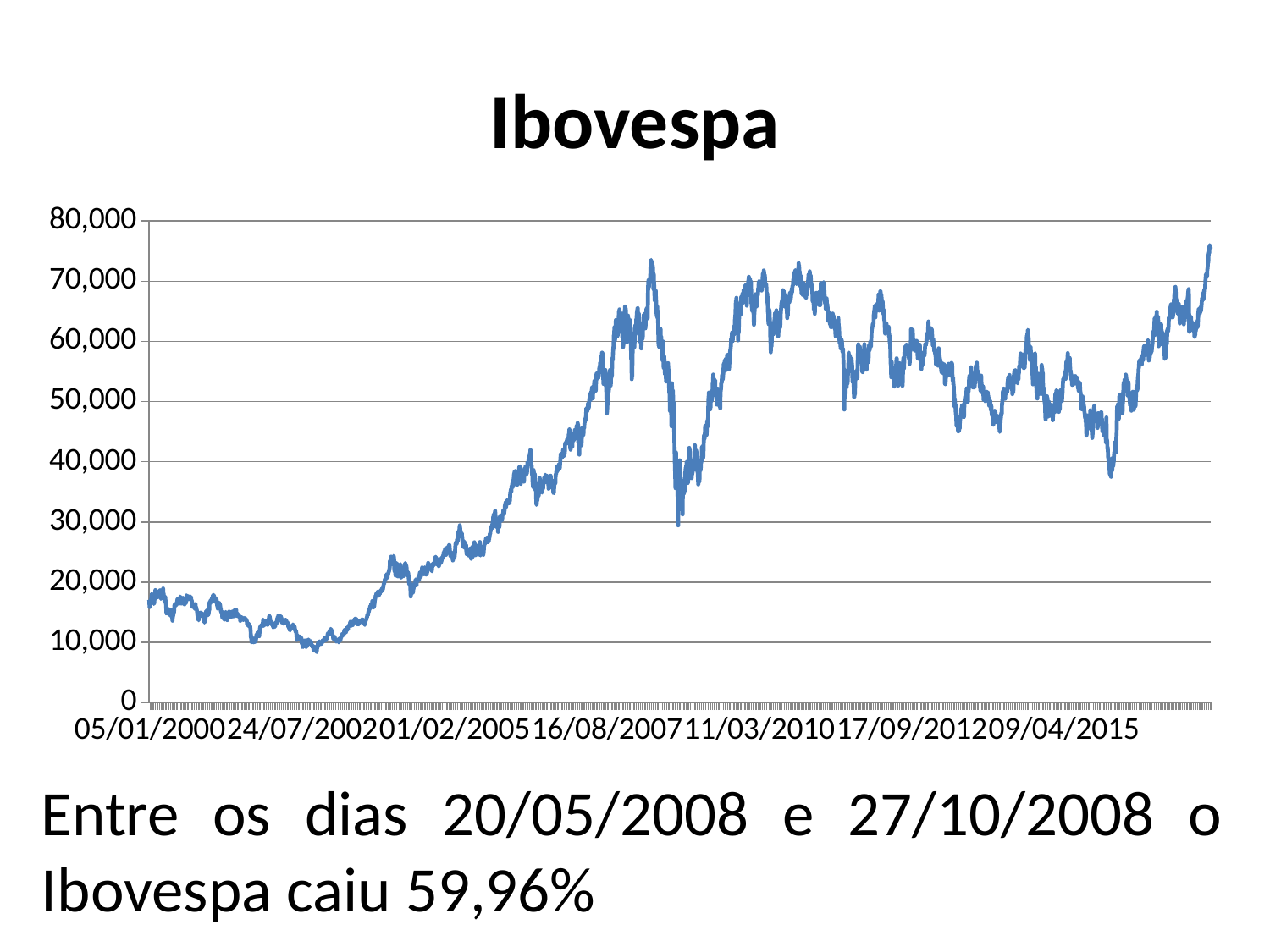
Is the value of the Ibovespa around 01/02/2005 greater or less than 40,000? less Is the value of the Ibovespa around 24/07/2002 greater or less than 20,000? less Which is larger: the Ibovespa value around 24/07/2002 or around 16/08/2007? 16/08/2007 Is the value of the Ibovespa around 17/09/2012 greater or less than 40,000? greater Overall, does the Ibovespa rise or fall between 05/01/2000 and the end of the series? rise What is the title of the chart? Ibovespa What kind of chart is shown on the slide? line chart Between 24/07/2002 and 16/08/2007, does the Ibovespa rise or fall? rise What is the highest value shown on the vertical axis of the chart? 80,000